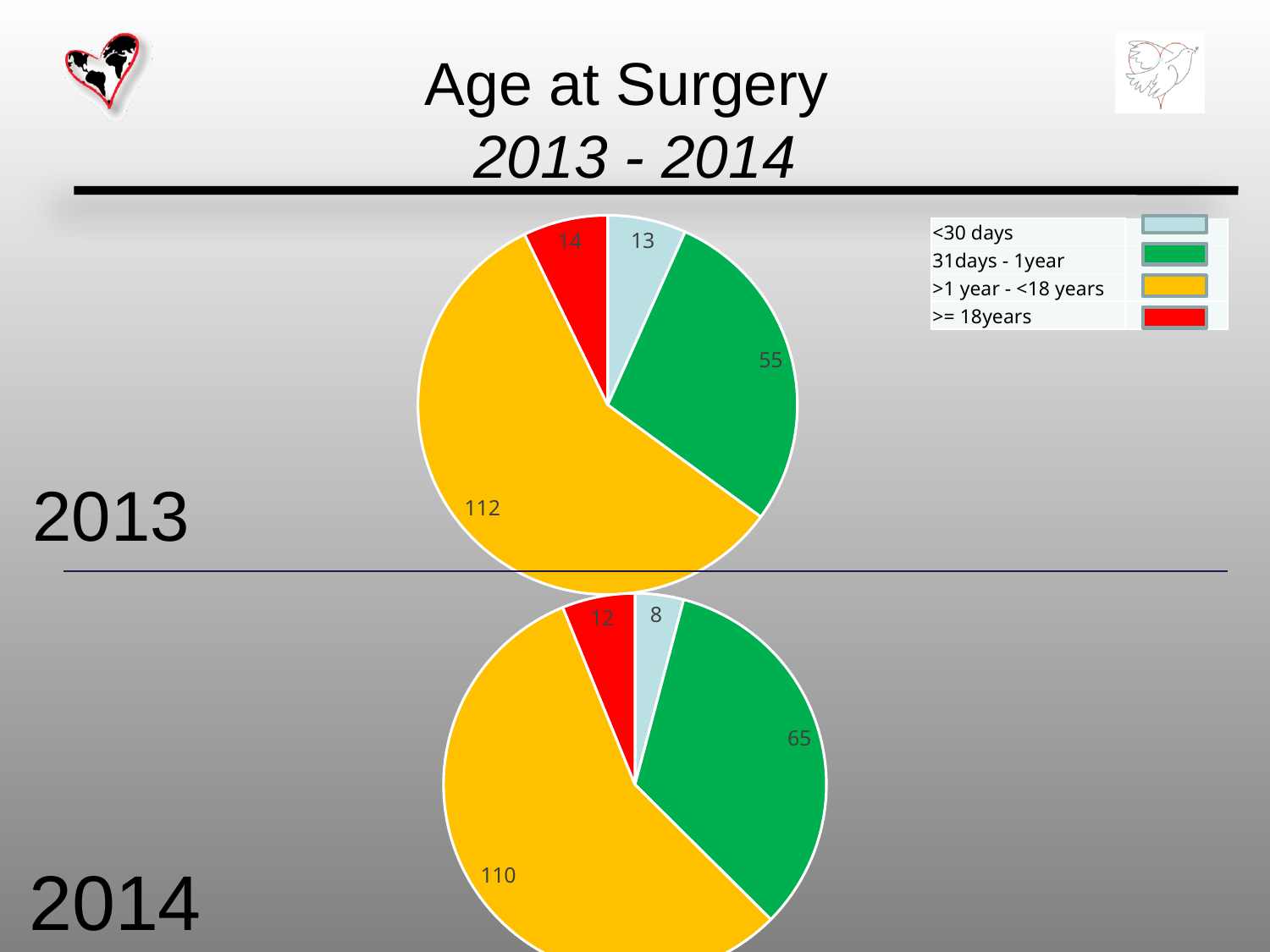
What is the difference between the 31days - 1year values in the 2014 and 2013 pie charts? 10 In the 2014 pie chart, which age group has the smallest slice? <30 days Which is larger: the <30 days value in the 2013 pie chart or in the 2014 pie chart? 2013 In the 2013 pie chart, which age group has the largest slice? >1 year - <18 years In the 2014 pie chart, what is the value for 31days - 1year? 65 In the 2014 pie chart, what is the value for >= 18years? 12 What type of charts are shown on the slide? Pie charts In the 2013 pie chart, what is the value for <30 days? 13 Which colour represents the >= 18years group in the legend? Red How many age groups does the legend list? 4 What is the total of all slices in the 2013 pie chart? 194 In the 2013 pie chart, what is the value for >1 year - <18 years? 112